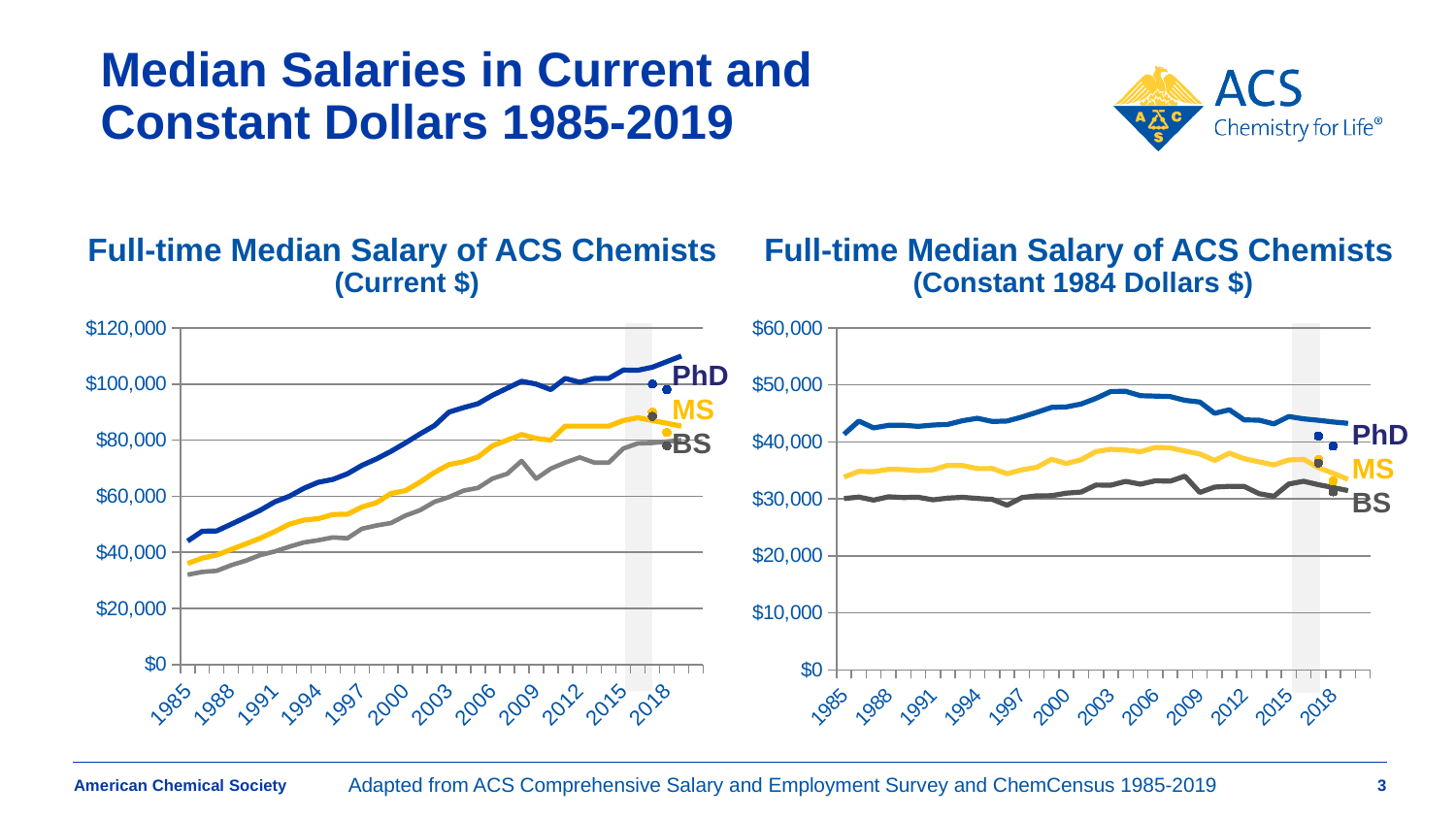
In the left chart (Current $), does the PhD median salary generally rise or fall from 1985 to 2018? rise What type of chart is the left chart, 'Full-time Median Salary of ACS Chemists (Current $)'? line chart In the right chart (Constant 1984 Dollars $), does the PhD median salary rise or fall from 2003 to 2018? fall In the left chart (Current $), which is larger in 2018, the PhD value or the BS value? PhD In the left chart (Current $), is the BS value in 1985 greater or less than $40,000? less In the right chart (Constant 1984 Dollars $), is the PhD value in 2018 greater or less than $40,000? greater In the right chart (Constant 1984 Dollars $), which series has the lowest values throughout the period? BS In the left chart (Current $), which series has the highest values throughout the period? PhD What is the maximum value shown on the y axis of the right chart (Constant 1984 Dollars $)? $60,000 In the left chart (Current $), is the PhD value in 2018 greater or less than $100,000? greater What is the title of the right chart? Full-time Median Salary of ACS Chemists (Constant 1984 Dollars $)